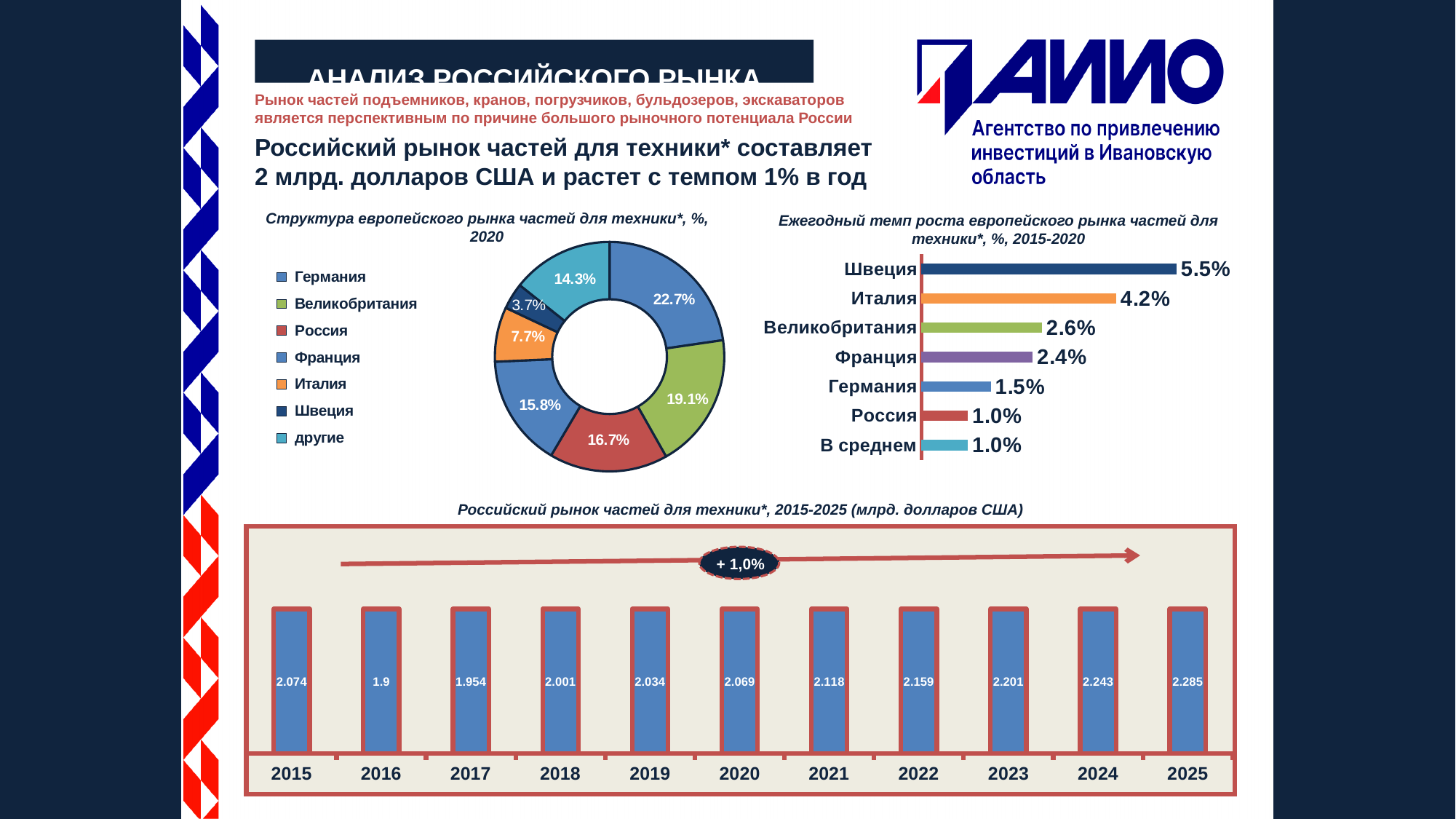
In the pie chart 'Структура европейского рынка частей для техники*, %, 2020', how many categories does the legend list? 7 In the pie chart 'Структура европейского рынка частей для техники*, %, 2020', what is the difference between the shares of Великобритания and Россия? 2.4% In the chart 'Российский рынок частей для техники*, 2015-2025 (млрд. долларов США)', how many years are shown on the x axis? 11 What kind of chart is 'Ежегодный темп роста европейского рынка частей для техники*, %, 2015-2020'? Bar chart In the pie chart 'Структура европейского рынка частей для техники*, %, 2020', which category has the smallest share? Швеция In the bar chart 'Ежегодный темп роста европейского рынка частей для техники*, %, 2015-2020', which country has the highest growth rate? Швеция In the chart 'Российский рынок частей для техники*, 2015-2025 (млрд. долларов США)', what is the difference between the values for 2025 and 2024? 0.042 In the bar chart 'Ежегодный темп роста европейского рынка частей для техники*, %, 2015-2020', which is larger, the value for Франция or for Германия? Франция In the pie chart 'Структура европейского рынка частей для техники*, %, 2020', what share does Германия have? 22.7% In the chart 'Российский рынок частей для техники*, 2015-2025 (млрд. долларов США)', what is the value for 2020? 2.069 In the bar chart 'Ежегодный темп роста европейского рынка частей для техники*, %, 2015-2020', what is the value for Италия? 4.2% In the bar chart 'Ежегодный темп роста европейского рынка частей для техники*, %, 2015-2020', what is the difference between the values for Швеция and Великобритания? 2.9%